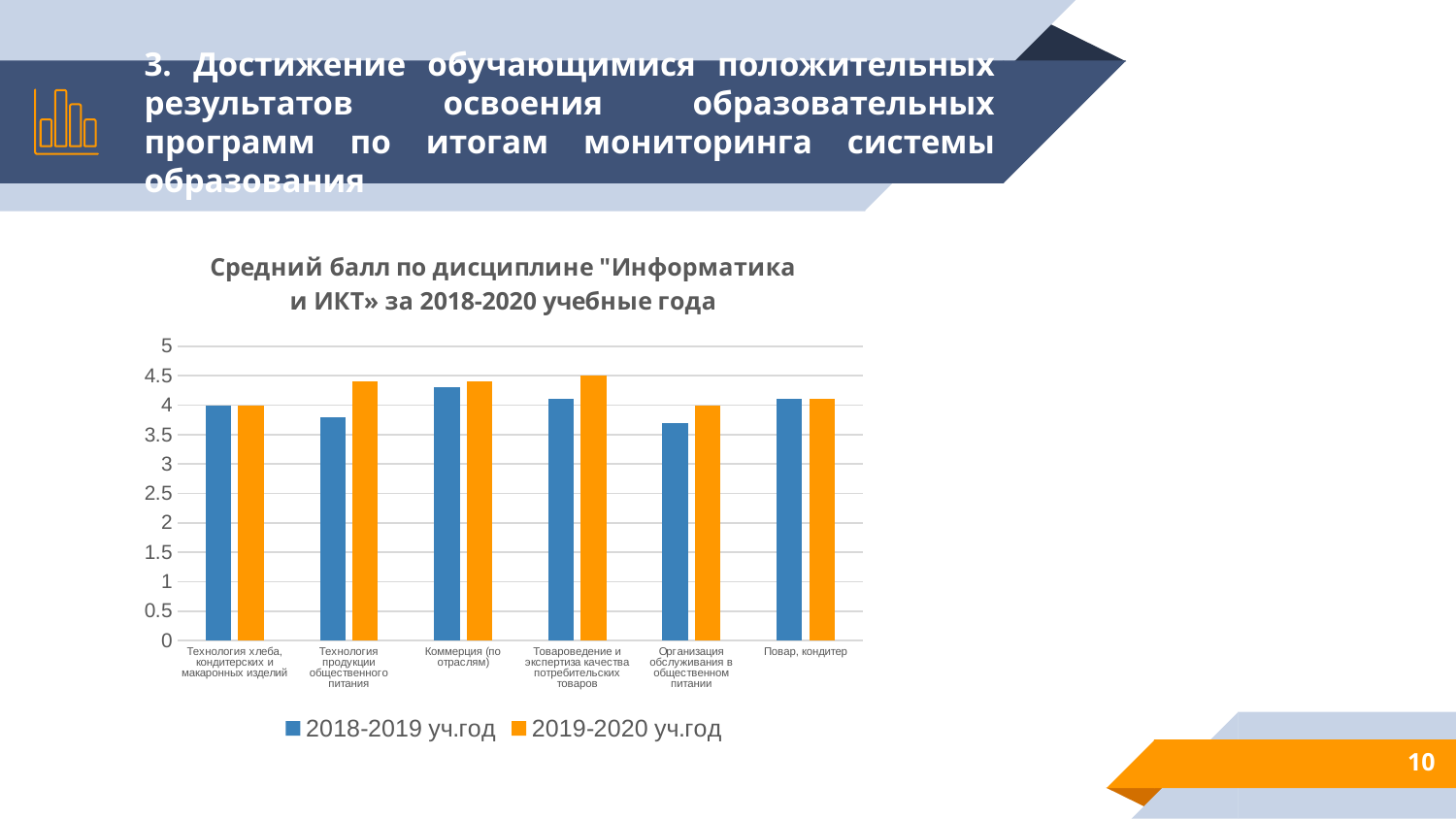
How many categories (specialities) are shown on the x axis of the chart? 6 Is the 2019-2020 уч.год value for "Товароведение и экспертиза качества потребительских товаров" greater or less than 4? greater Is the 2018-2019 уч.год value for "Коммерция (по отраслям)" greater or less than 4? greater How many series does the chart legend list? 2 What kind of chart is shown on the slide? bar chart What is the title of the chart? Средний балл по дисциплине "Информатика и ИКТ» за 2018-2020 учебные года For "Технология продукции общественного питания", which series has the larger value: 2018-2019 уч.год or 2019-2020 уч.год? 2019-2020 уч.год Which two series are listed in the chart legend? 2018-2019 уч.год and 2019-2020 уч.год For "Организация обслуживания в общественном питании", which series has the larger value: 2018-2019 уч.год or 2019-2020 уч.год? 2019-2020 уч.год Is the 2018-2019 уч.год value for "Организация обслуживания в общественном питании" greater or less than 4? less In the 2018-2019 уч.год series, which is larger: "Коммерция (по отраслям)" or "Технология хлеба, кондитерских и макаронных изделий"? Коммерция (по отраслям)